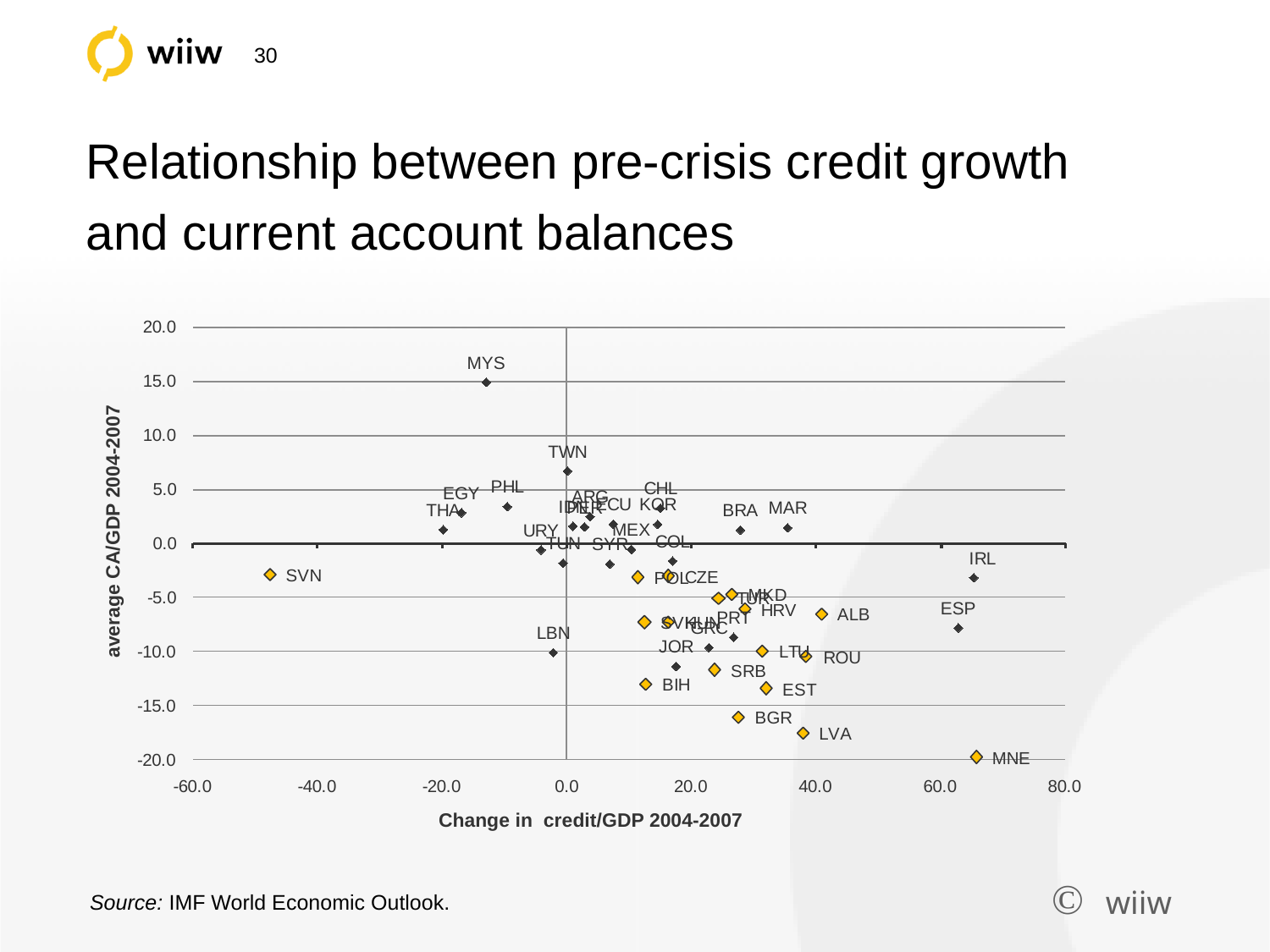
Is the average CA/GDP value for LVA greater or less than -15.0? less Which has the larger change in credit/GDP, SVN or MNE? MNE What is the title of the horizontal axis? Change in credit/GDP 2004-2007 Is the average CA/GDP value for TWN greater or less than 5.0? greater Which country has the lowest change in credit/GDP 2004-2007? SVN Is the average CA/GDP value for MYS greater or less than 10.0? greater Which country has the highest average CA/GDP 2004-2007 value? MYS What kind of chart is shown on the slide? scatter chart Which country has the lowest average CA/GDP 2004-2007 value? MNE Which has the higher average CA/GDP value, IRL or ESP? IRL